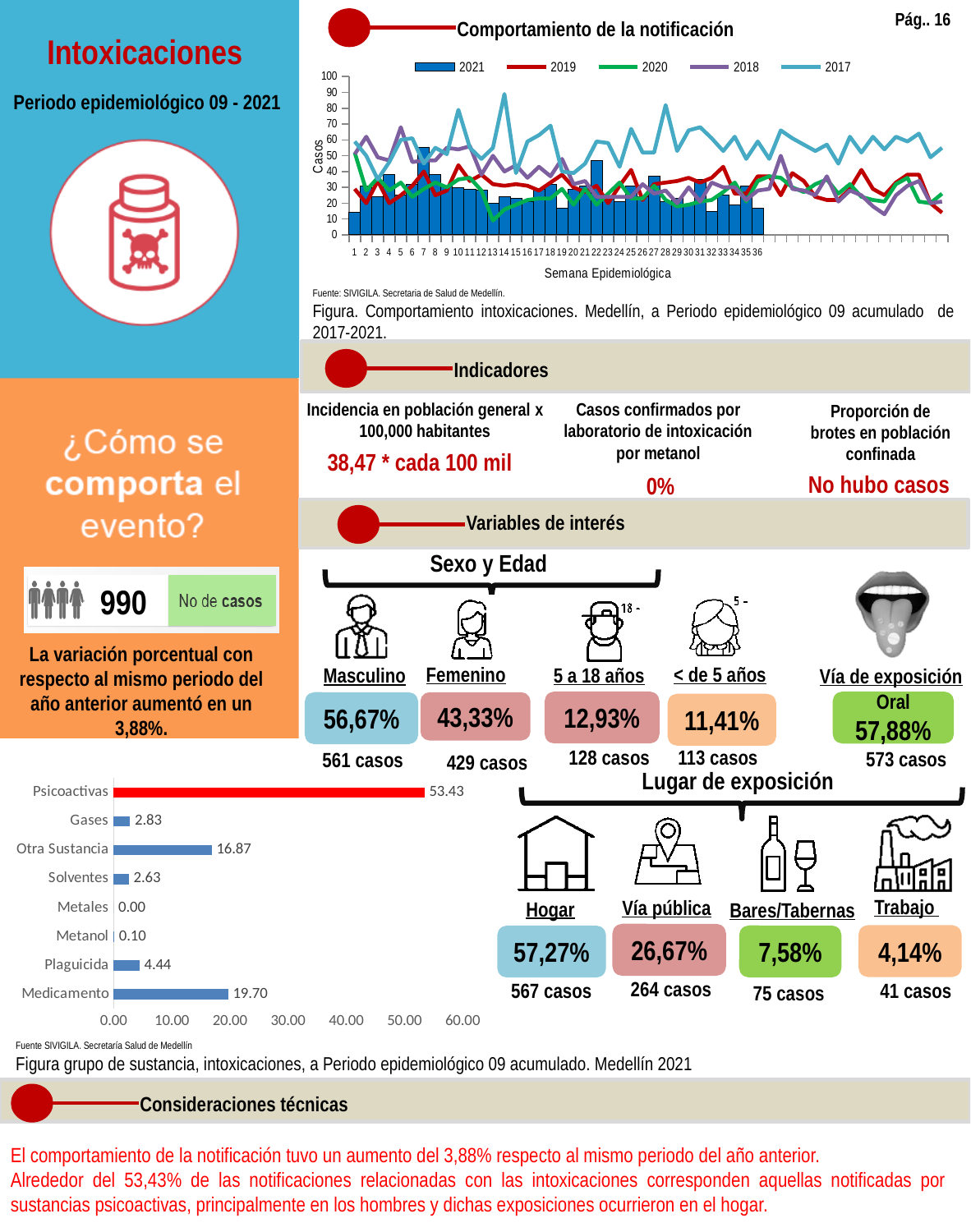
What kind of chart is the bottom-left chart of substance groups? Bar chart In the bottom-left bar chart of substance groups, which is larger, Gases or Solventes? Gases How many categories are shown in the bottom-left bar chart of substance groups? 8 How many series does the legend of the 'Comportamiento de la notificación' chart list? 5 In the bottom-left bar chart of substance groups, which category has the highest value? Psicoactivas In the bottom-left bar chart of substance groups, what is the difference between Otra Sustancia and Medicamento? 2.83 In the bottom-left bar chart of substance groups, which category has the lowest value? Metales In the bottom-left bar chart of substance groups, what is the value for Psicoactivas? 53.43 In the bottom-left bar chart of substance groups, what is the value for Medicamento? 19.70 In the 'Comportamiento de la notificación' chart, is the 2021 bar for week 1 greater or less than 20? less What is the x-axis label of the 'Comportamiento de la notificación' chart? Semana Epidemiológica In the bottom-left bar chart of substance groups, what is the value for Plaguicida? 4.44